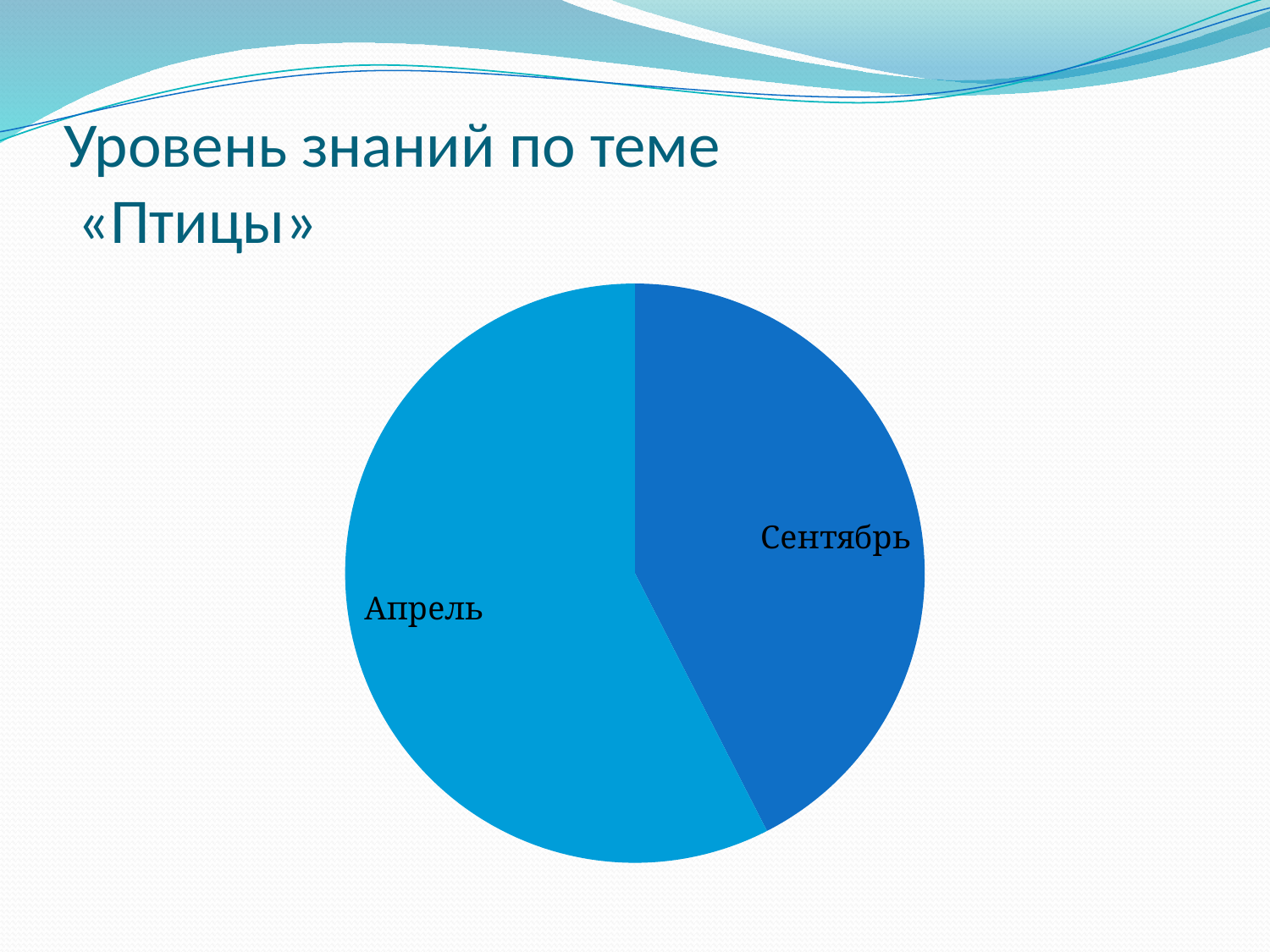
Which slice of the pie chart is the smallest? Сентябрь What is the title of the slide containing the pie chart? Уровень знаний по теме «Птицы» How many slices does the pie chart have? 2 Does the Апрель slice take up more or less than half of the pie? more Which slice is larger, Апрель or Сентябрь? Апрель What kind of chart is shown on the slide? pie chart Which slice of the pie chart is the largest? Апрель Which slice of the pie chart is drawn in the darker blue colour? Сентябрь